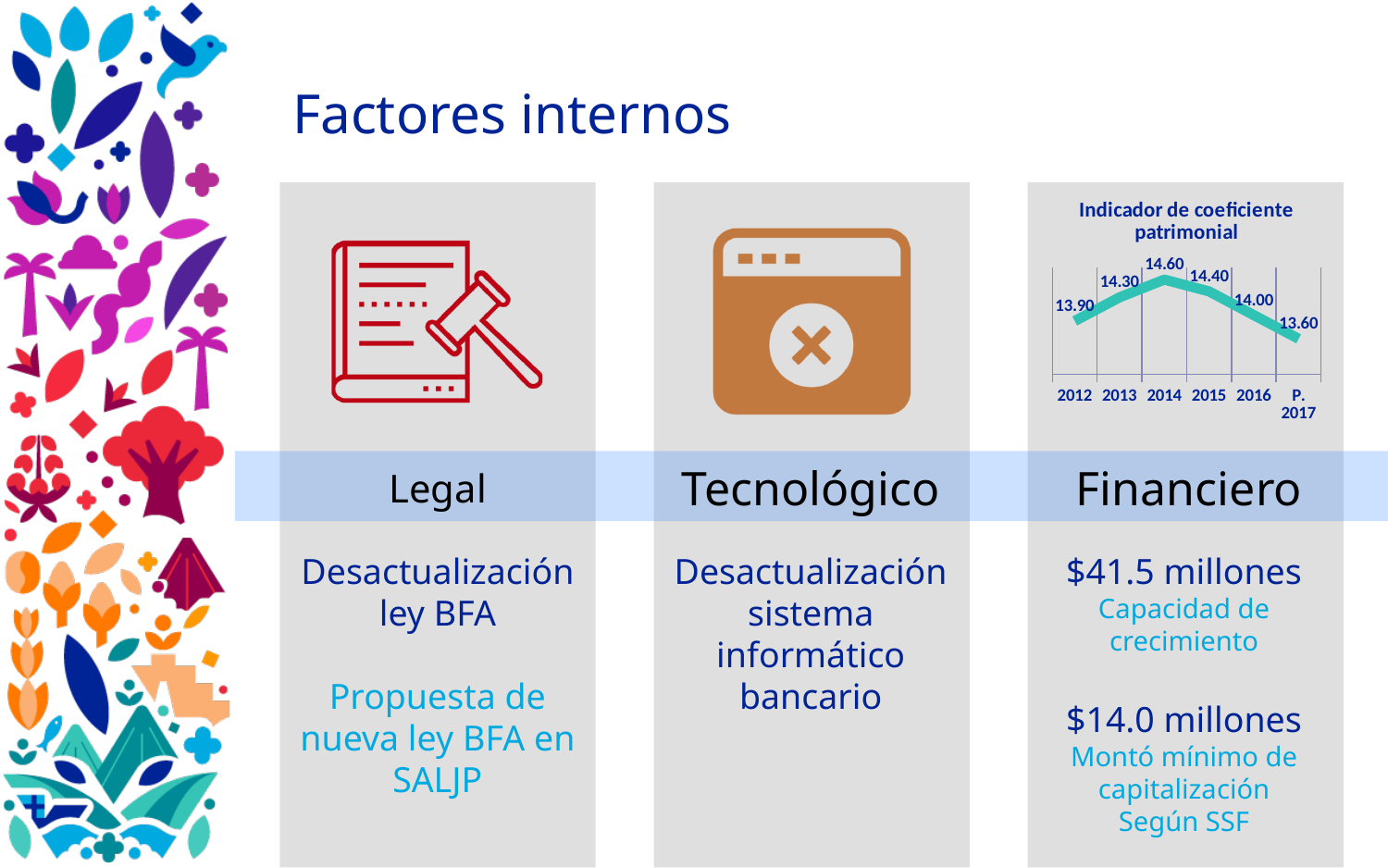
What is the title of the chart on the slide? Indicador de coeficiente patrimonial What is the value of the indicator for 2012? 13.90 Which year has the lowest value in the chart? P. 2017 How many data points are plotted in the chart? 6 What is the value of the indicator for P. 2017? 13.60 What is the difference between the values for 2014 and P. 2017? 1.00 Does the value rise or fall from 2014 to P. 2017? fall What is the value of the indicator for 2014? 14.60 What type of chart is shown on the slide? line chart What is the difference between the values for 2015 and 2016? 0.40 Which year has the highest value in the chart? 2014 Which is larger, the value for 2013 or the value for 2016? 2013